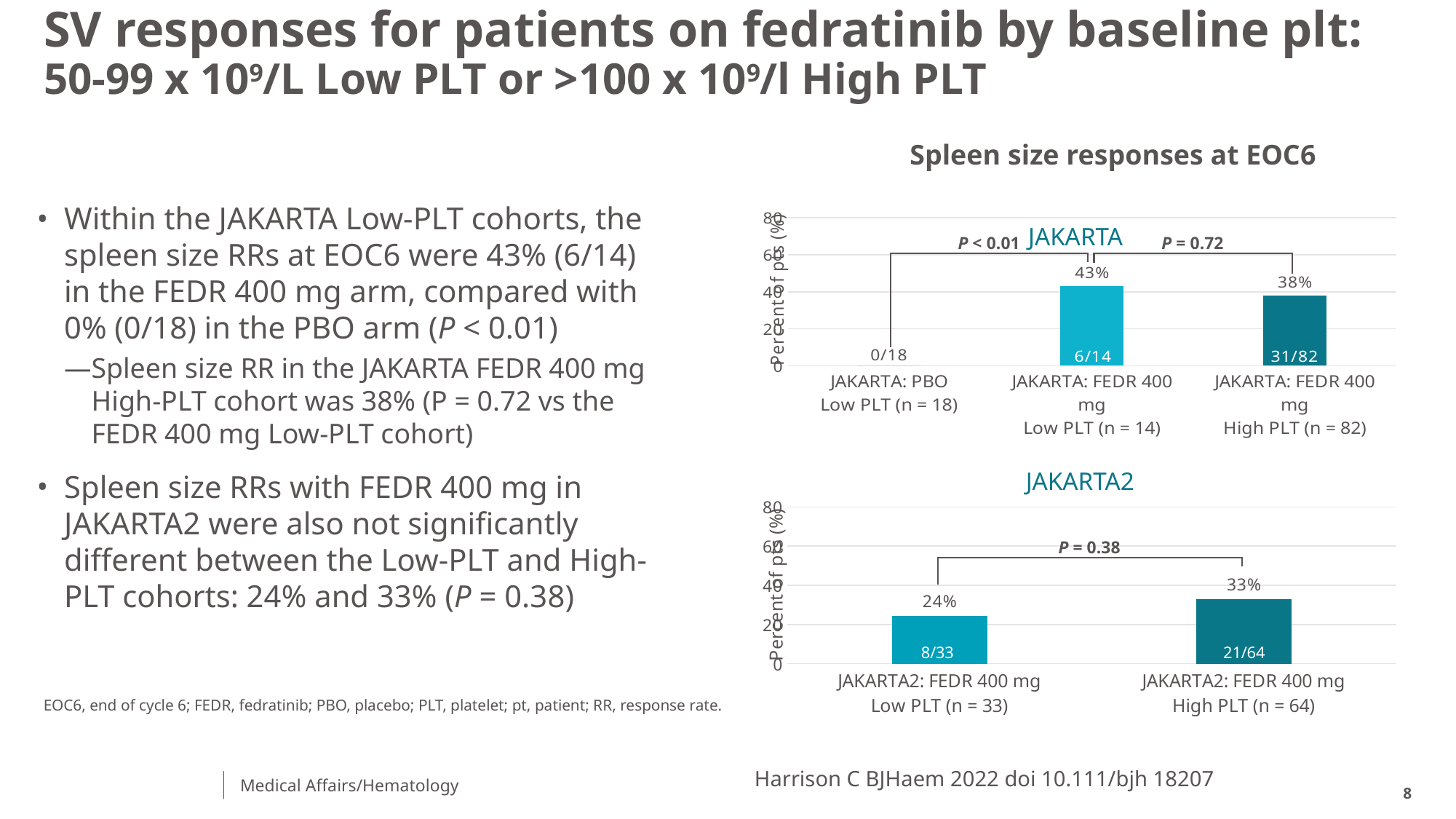
In the JAKARTA chart, what fraction of patients responded in the JAKARTA: PBO Low PLT (n = 18) group? 0/18 How many groups are plotted in the JAKARTA chart? 3 In the JAKARTA chart, which group has the highest response rate? JAKARTA: FEDR 400 mg Low PLT (n = 14) In the JAKARTA chart, what is the spleen size response rate for JAKARTA: FEDR 400 mg Low PLT (n = 14)? 43% In the JAKARTA chart, which group has the lowest response rate? JAKARTA: PBO Low PLT (n = 18) In the JAKARTA2 chart, what is the difference in response rate between the High PLT and Low PLT groups? 9% What type of chart is the JAKARTA2 chart? Bar chart In the JAKARTA2 chart, what is the response rate for JAKARTA2: FEDR 400 mg Low PLT (n = 33)? 24% In the JAKARTA2 chart, what fraction is shown for JAKARTA2: FEDR 400 mg High PLT (n = 64)? 21/64 In the JAKARTA chart, what is the difference in response rate between the FEDR 400 mg Low PLT and High PLT groups? 5% In the JAKARTA2 chart, which group has the larger response rate, Low PLT (n = 33) or High PLT (n = 64)? High PLT (n = 64) In the JAKARTA chart, what is the spleen size response rate for JAKARTA: FEDR 400 mg High PLT (n = 82)? 38%